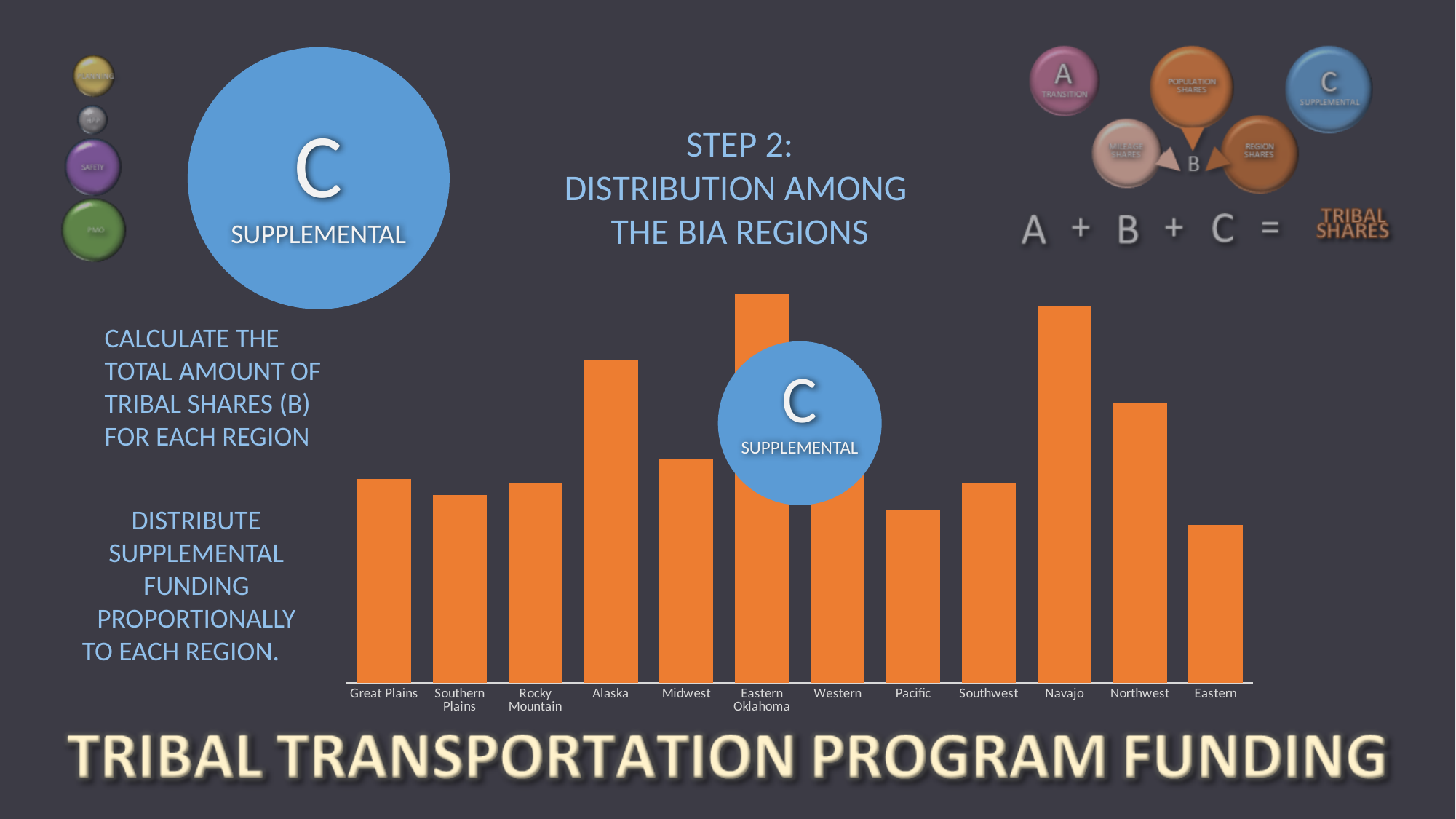
Which region has the tallest bar in the chart? Eastern Oklahoma Which bar is taller, Pacific or Rocky Mountain? Rocky Mountain Which region has the shortest bar in the chart? Eastern Which bar is taller, Great Plains or Eastern? Great Plains Which bar is taller, Southwest or Northwest? Northwest How many regions are shown along the x axis of the chart? 12 What colour are the bars in the chart? orange What kind of chart is shown on the slide? bar chart What is the label of the first category on the left of the x axis? Great Plains